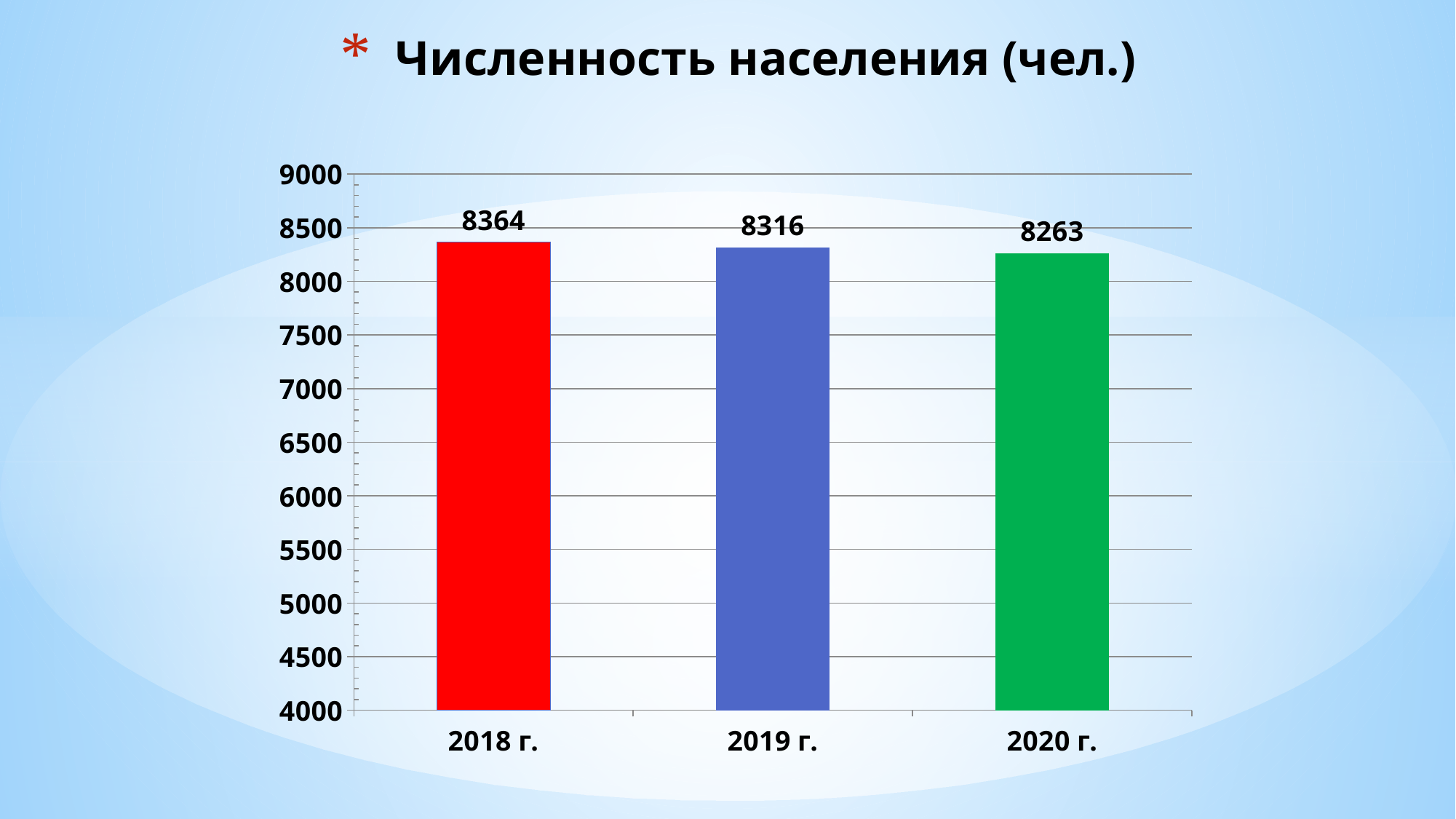
What is the difference between the population values for 2018 г. and 2019 г.? 48 What is the population value shown for 2019 г.? 8316 What kind of chart is shown on the slide? bar chart Is the value for 2020 г. greater or less than 8500? less How many years are shown on the chart? 3 Which year has the highest population value? 2018 г. What is the difference between the population values for 2018 г. and 2020 г.? 101 Which is larger, the value for 2019 г. or the value for 2020 г.? 2019 г. Which year has the lowest population value? 2020 г. What is the population value shown for 2020 г.? 8263 Do the population values rise or fall from 2018 г. to 2020 г.? fall What is the population value shown for 2018 г.? 8364